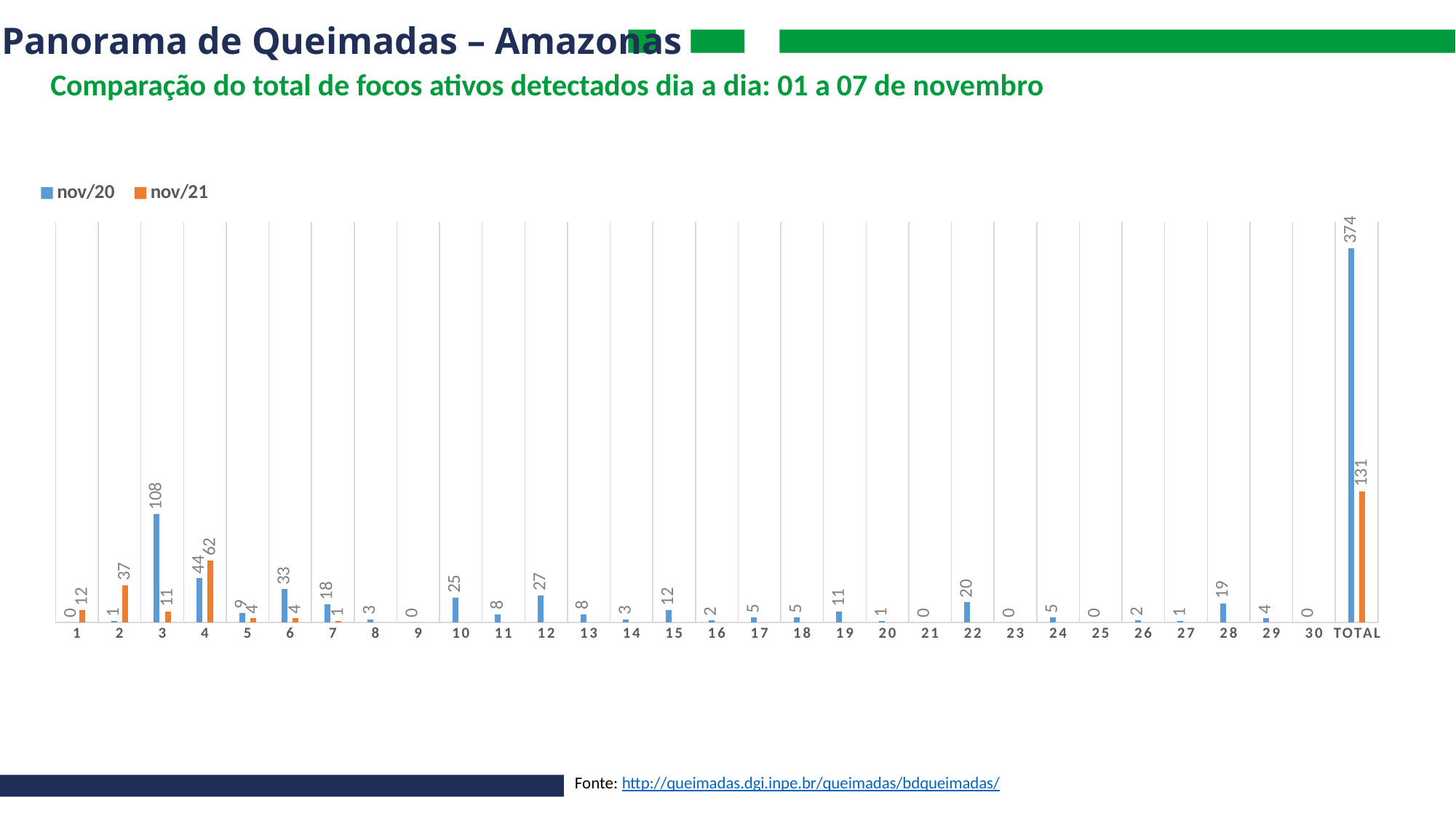
How many series does the legend list? 2 What is the nov/20 value for day 3? 108 What is the difference between the nov/20 and nov/21 values in the TOTAL category? 243 What is the nov/21 value for day 4? 62 What kind of chart is shown on the slide? bar chart Excluding the TOTAL category, which day has the highest nov/21 value? 4 What is the difference between the nov/20 and nov/21 values for day 3? 97 Excluding the TOTAL category, which day has the highest nov/20 value? 3 What is the nov/21 value for the TOTAL category? 131 For day 4, which series has the larger value, nov/20 or nov/21? nov/21 What are the two entries in the chart legend? nov/20 and nov/21 What is the nov/20 value for day 22? 20